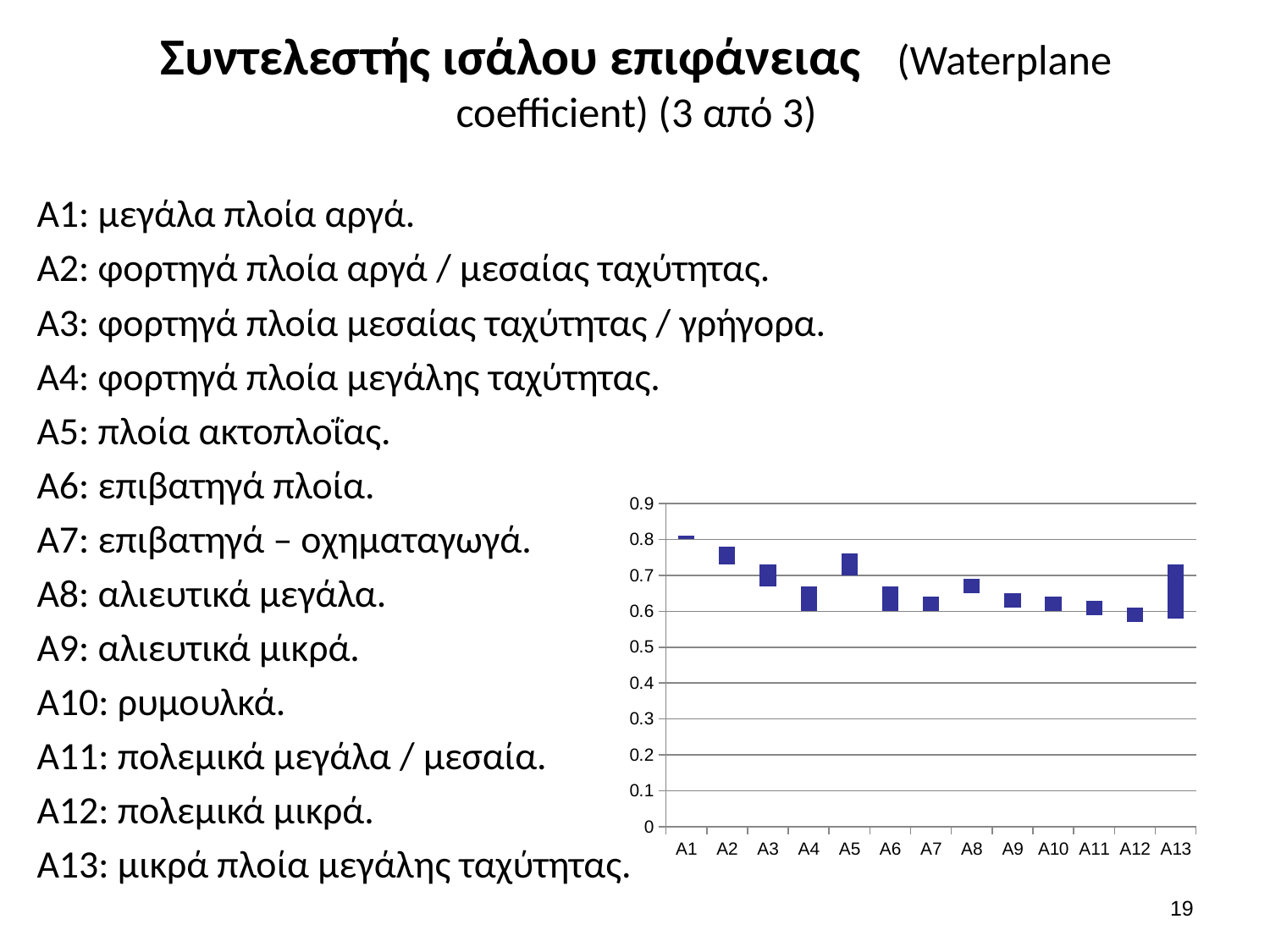
Is the value for A12 greater or less than 0.7? less Which category has the highest bar in the chart? A1 Is the value for A1 greater or less than 0.7? greater Do the bar values generally rise or fall from A1 to A12 along the x axis? fall Which is larger, the value for A1 or the value for A12? A1 What is the highest tick value shown on the y axis of the chart? 0.9 Is the value for A4 greater or less than 0.7? less How many categories are shown on the x axis of the chart? 13 Which is larger, the value for A2 or the value for A4? A2 What kind of chart is shown on the slide? bar chart